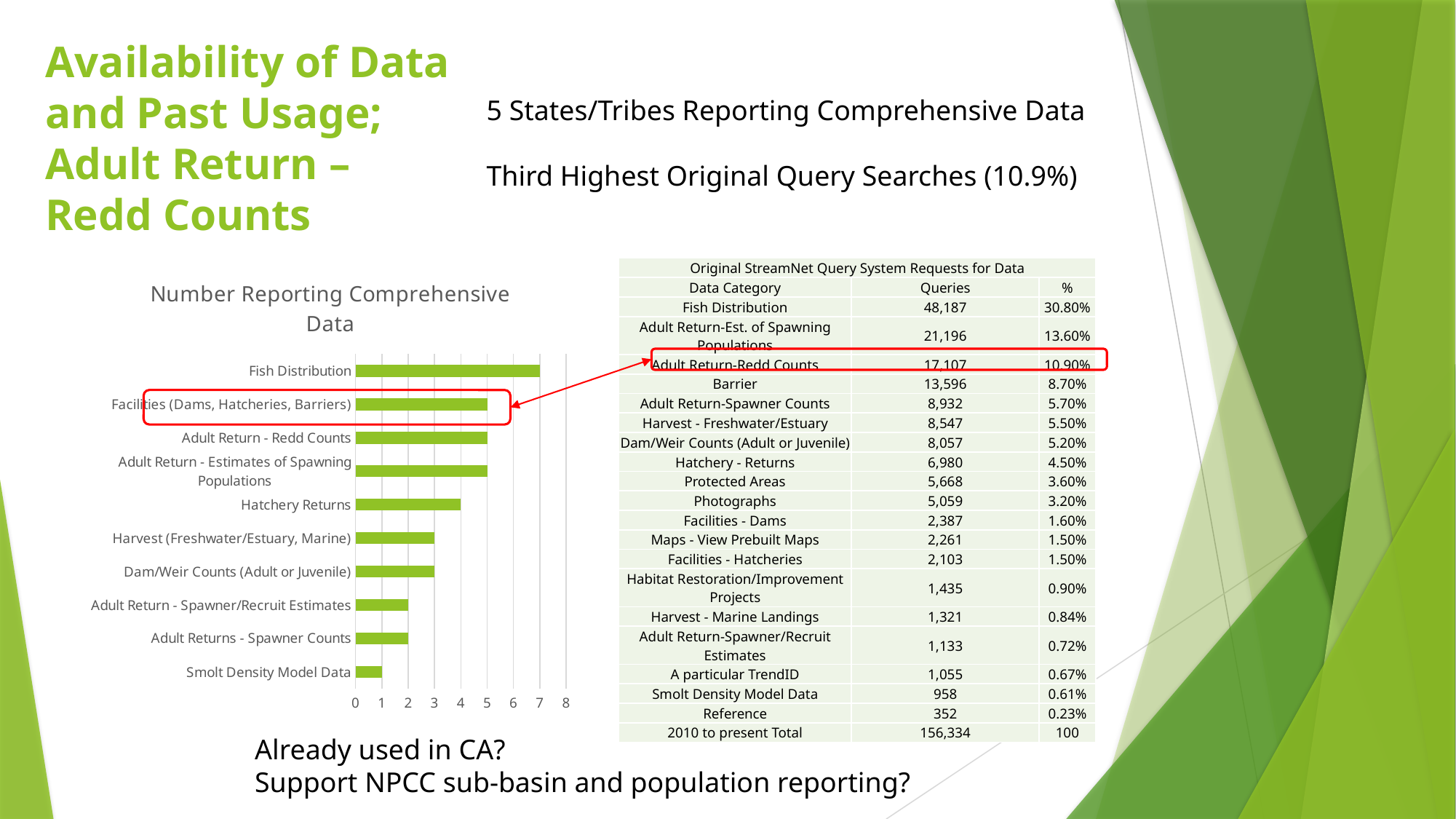
What is the difference between the values for Fish Distribution and Smolt Density Model Data? 6 What is the title of the chart on the slide? Number Reporting Comprehensive Data What is the value for Hatchery Returns in the chart? 4 What kind of chart is shown on the slide? bar chart How many categories are plotted in the chart? 10 Is the value for Harvest (Freshwater/Estuary, Marine) greater or less than 5? less What is the value for Fish Distribution in the chart? 7 What is the value for Adult Return - Redd Counts in the chart? 5 Which is larger, the value for Fish Distribution or the value for Hatchery Returns? Fish Distribution Which category has the lowest value in the chart? Smolt Density Model Data What is the value for Smolt Density Model Data in the chart? 1 Which category has the highest value in the chart? Fish Distribution